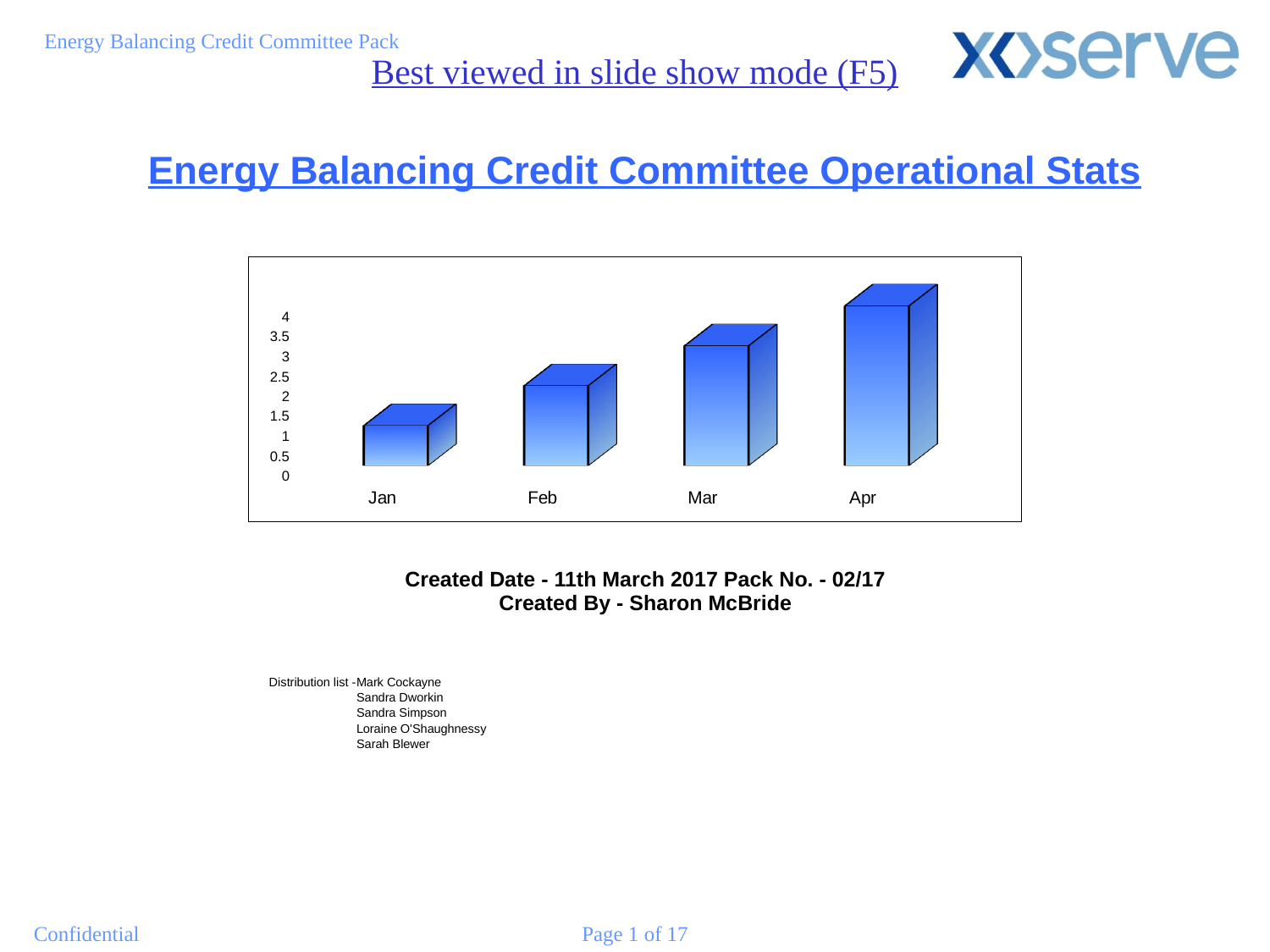
What colour are the bars in the chart? blue Which is larger in the chart, the value for Jan or the value for Apr? Apr Is the value for Mar greater or less than 2? greater Which month has the lowest bar in the chart? Jan Which month has the highest bar in the chart? Apr Is the value for Feb greater or less than 3? less Do the values rise or fall from Jan to Apr in the chart? rise Is the value for Apr greater or less than 3? greater What kind of chart is shown on the slide? bar chart Which is larger in the chart, the value for Mar or the value for Feb? Mar How many categories are plotted on the x axis of the chart? 4